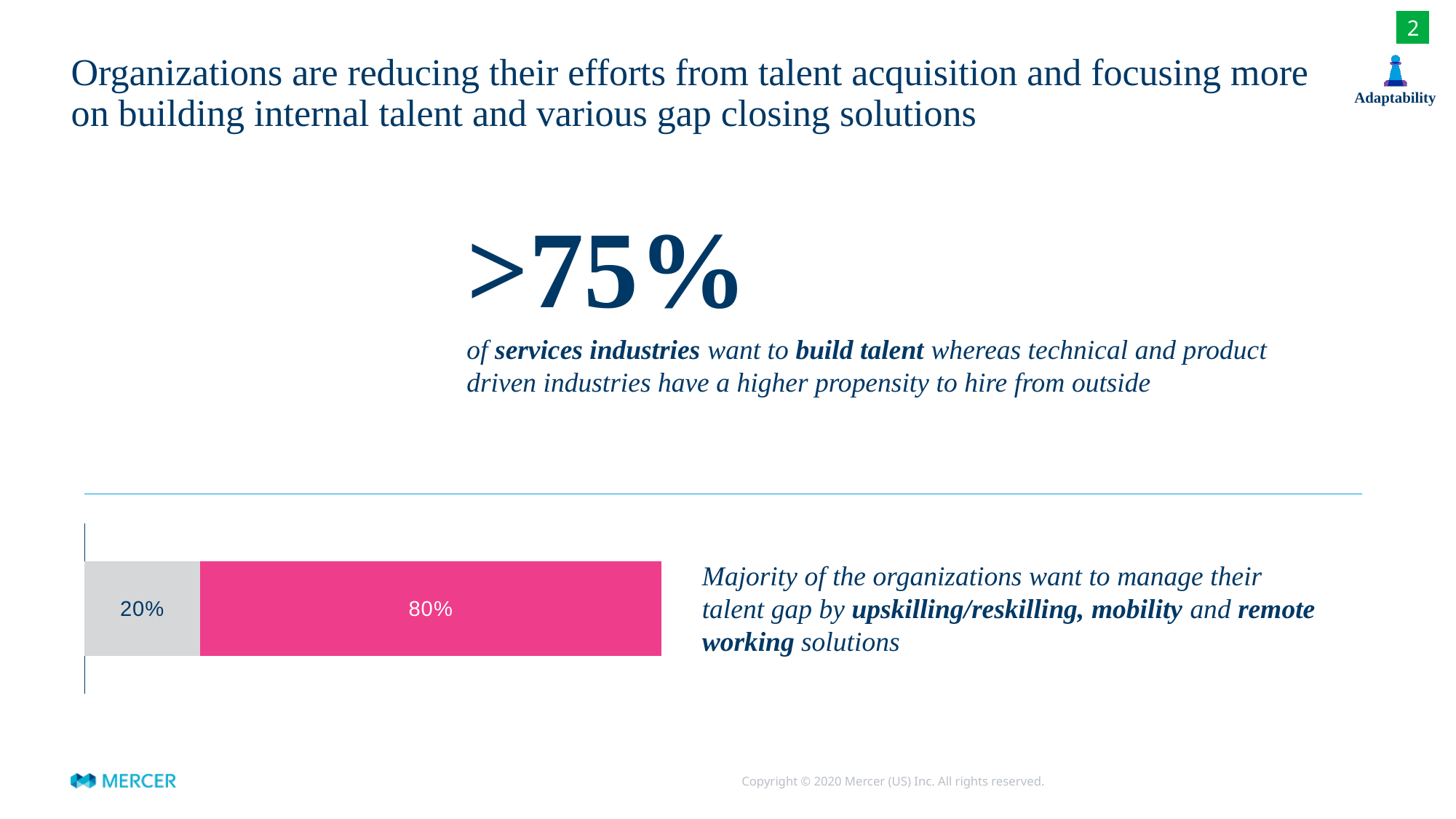
What is the largest value shown in the bar? 80% What value is printed on the grey segment of the bar? 20% How many segments does the stacked bar at the bottom of the slide contain? 2 What colour is the segment labelled 80%? pink What is the smallest value shown in the bar? 20% What is the total of the two segments in the stacked bar? 100% What is the difference between the pink segment's value and the grey segment's value? 60% Which segment of the bar is larger, the grey one or the pink one? the pink one What value is printed on the pink segment of the bar? 80% Is the bar on the slide oriented horizontally or vertically? horizontally What kind of chart is shown at the bottom of the slide? bar chart